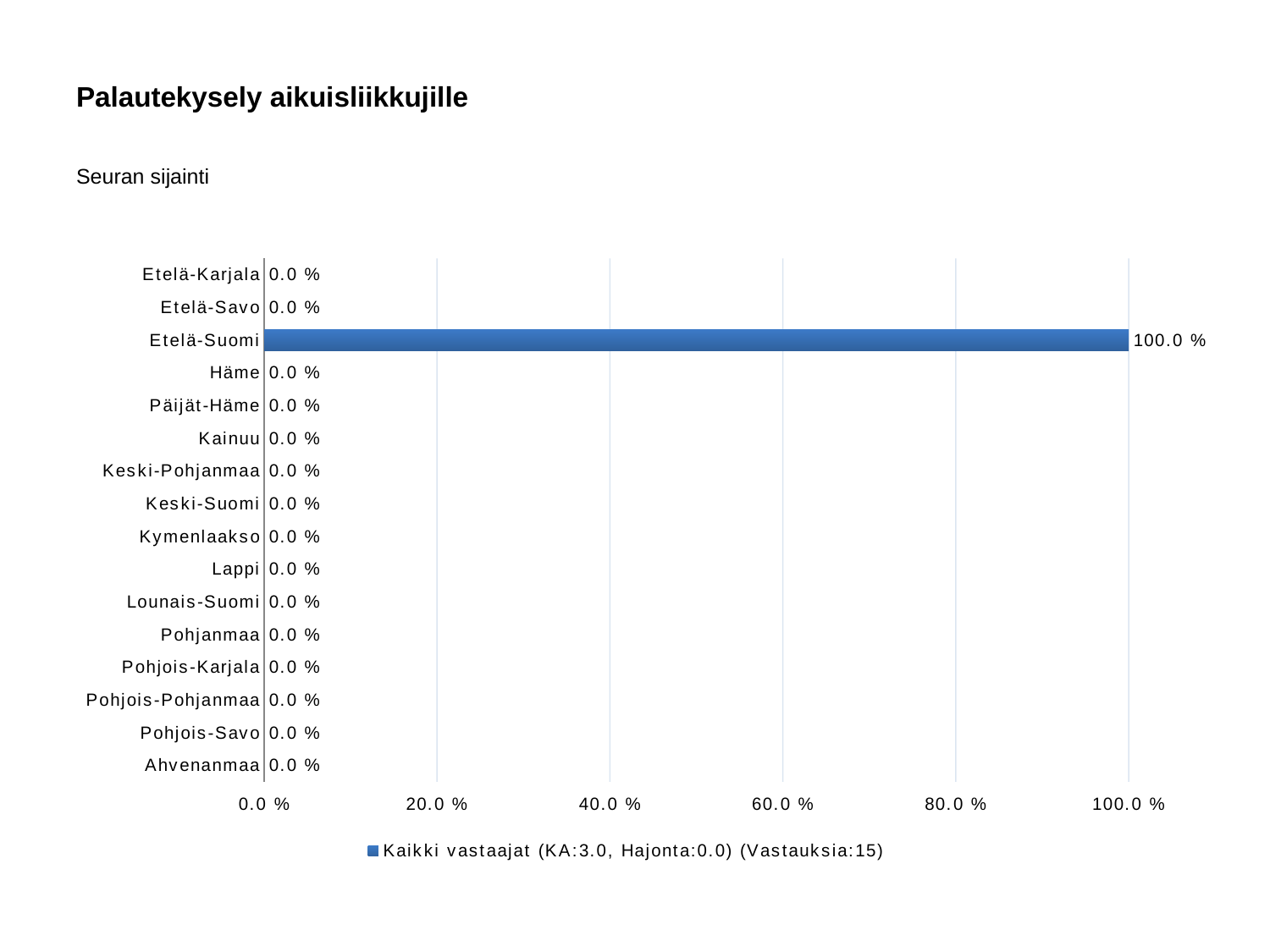
What kind of chart is shown on the slide? bar chart What is the difference between the values for Etelä-Suomi and Häme? 100.0 % Which category has the highest value? Etelä-Suomi What is the value for Pohjois-Pohjanmaa? 0.0 % What is the value for Lappi? 0.0 % Is the value for Etelä-Suomi greater or less than 80.0 %? greater What is the legend entry for the series? Kaikki vastaajat (KA:3.0, Hajonta:0.0) (Vastauksia:15) How many series does the legend list? 1 What is the subtitle of the chart? Seuran sijainti How many categories are shown on the chart? 16 Which is larger, the value for Etelä-Suomi or the value for Kainuu? Etelä-Suomi What is the value for Etelä-Suomi? 100.0 %